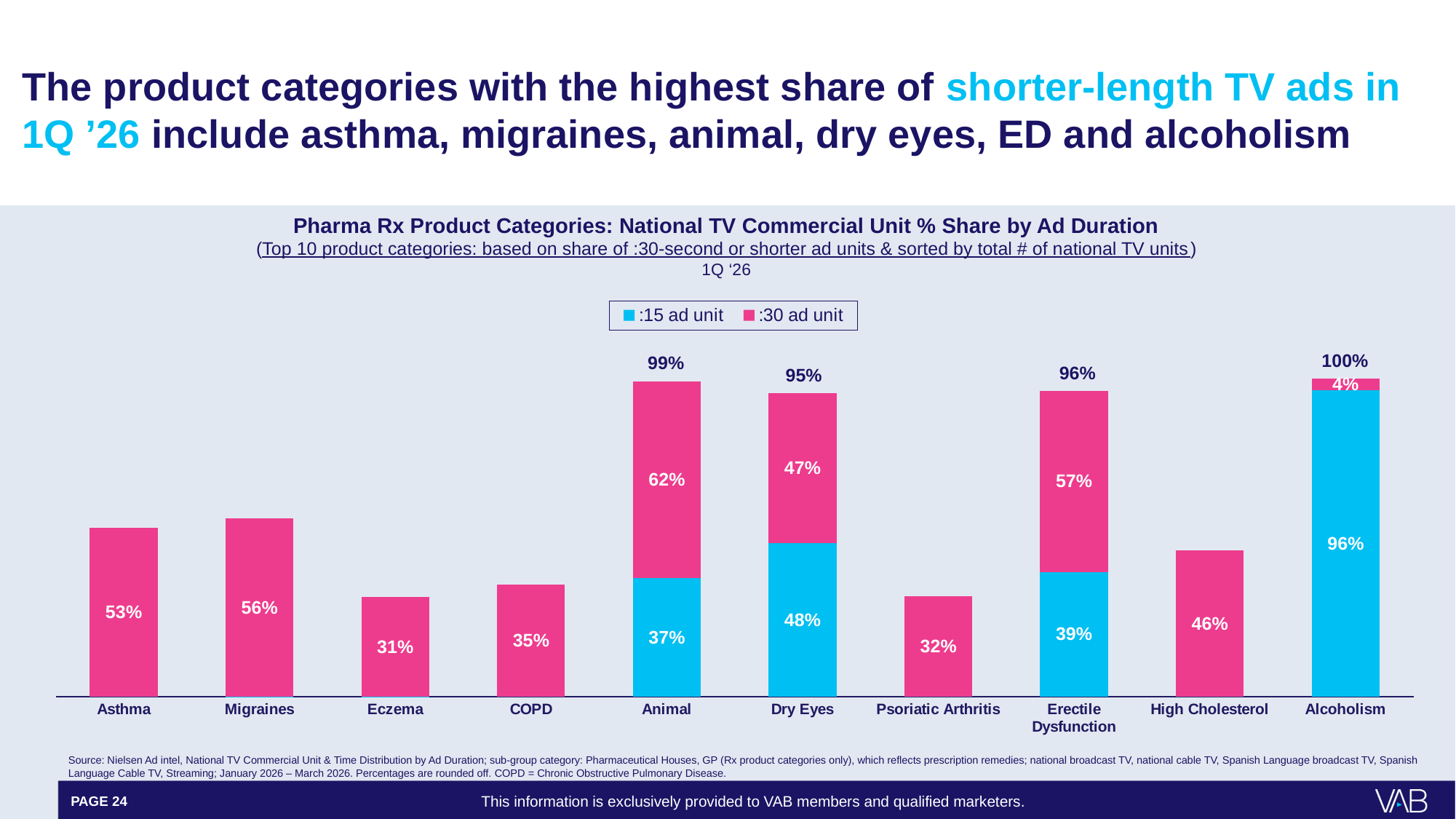
What is the :15 ad unit share for Alcoholism? 96% What is the :15 ad unit share for Dry Eyes? 48% Which category has the highest :15 ad unit share? Alcoholism What is the total share labelled above the Animal bar? 99% Which category has the lowest :30 ad unit share? Alcoholism Which is larger, the :30 ad unit share for High Cholesterol or for Psoriatic Arthritis? High Cholesterol What is the :30 ad unit share for Erectile Dysfunction? 57% What kind of chart is shown on the slide? Stacked bar chart What is the difference between the :30 ad unit shares for Migraines and COPD? 21% What is the :30 ad unit share for Asthma? 53% How many series does the legend list? 2 How many product categories are shown on the x axis? 10